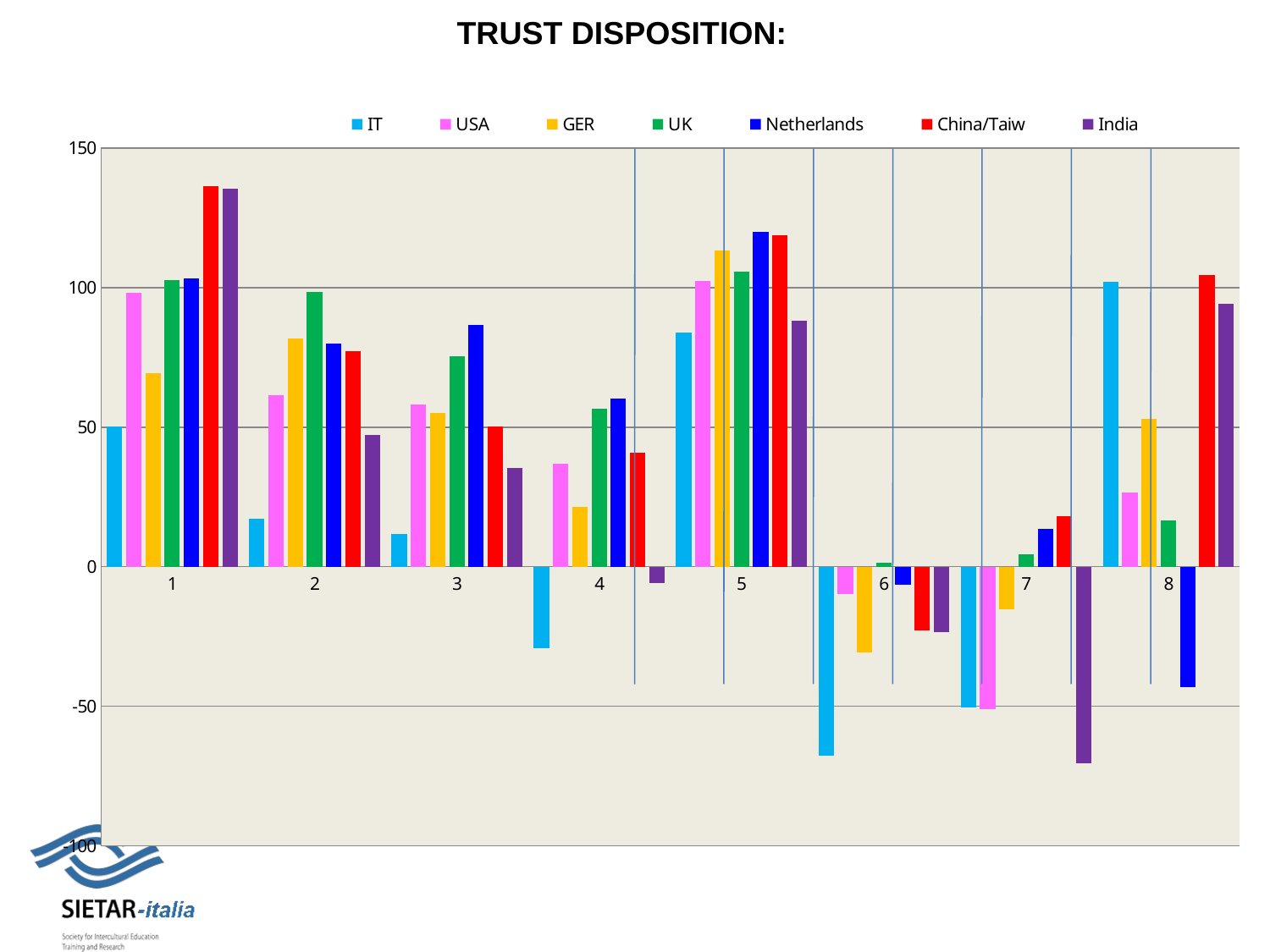
Which series has the lowest value in category 7? India In category 3, which is larger: the value for Netherlands or the value for UK? Netherlands Is the value for China/Taiw in category 1 greater or less than 100? greater Is the value for India in category 7 greater or less than -50? less Is the value for IT in category 6 greater or less than -50? less How many categories are shown along the x axis? 8 What is the title of the chart? TRUST DISPOSITION: How many series does the legend list? 7 Which series has the lowest value in category 6? IT What kind of chart is shown on the slide? bar chart Which series has the highest value in category 2? UK